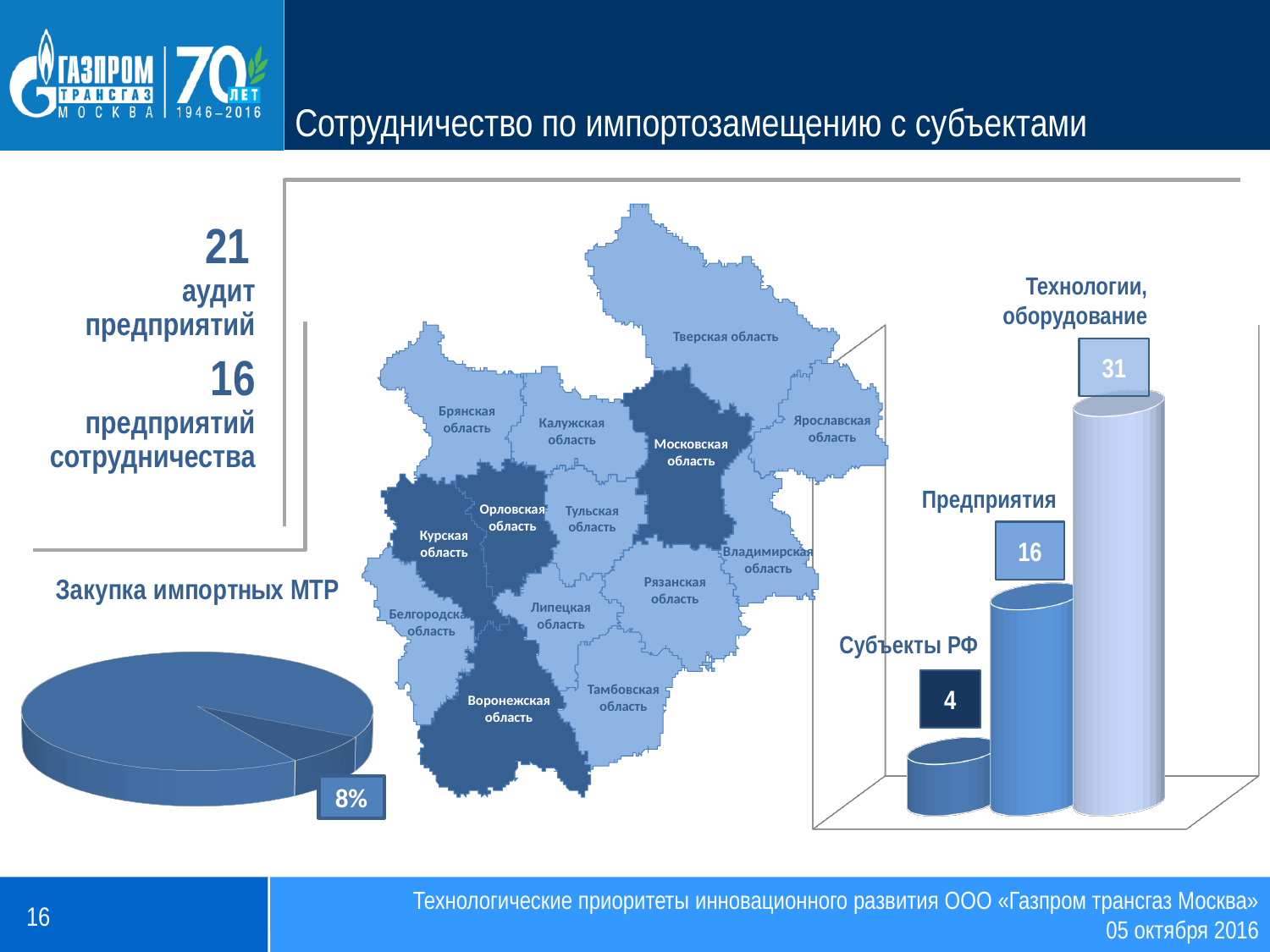
In the bar chart on the right, what is the value for Предприятия? 16 In the bar chart on the right, which category has the highest value? Технологии, оборудование What kind of chart is shown at the bottom left of the slide under Закупка импортных МТР? pie chart How many bars are shown in the bar chart on the right? 3 In the pie chart titled Закупка импортных МТР, what share is shown for the labelled slice? 8% What kind of chart is shown on the right side of the slide? bar chart In the bar chart on the right, what is the difference between the values for Предприятия and Субъекты РФ? 12 In the bar chart on the right, what is the difference between the values for Технологии, оборудование and Предприятия? 15 In the bar chart on the right, what is the value for Технологии, оборудование? 31 In the bar chart on the right, which is larger: the value for Предприятия or the value for Субъекты РФ? Предприятия In the bar chart on the right, which category has the lowest value? Субъекты РФ In the bar chart on the right, what is the value for Субъекты РФ? 4